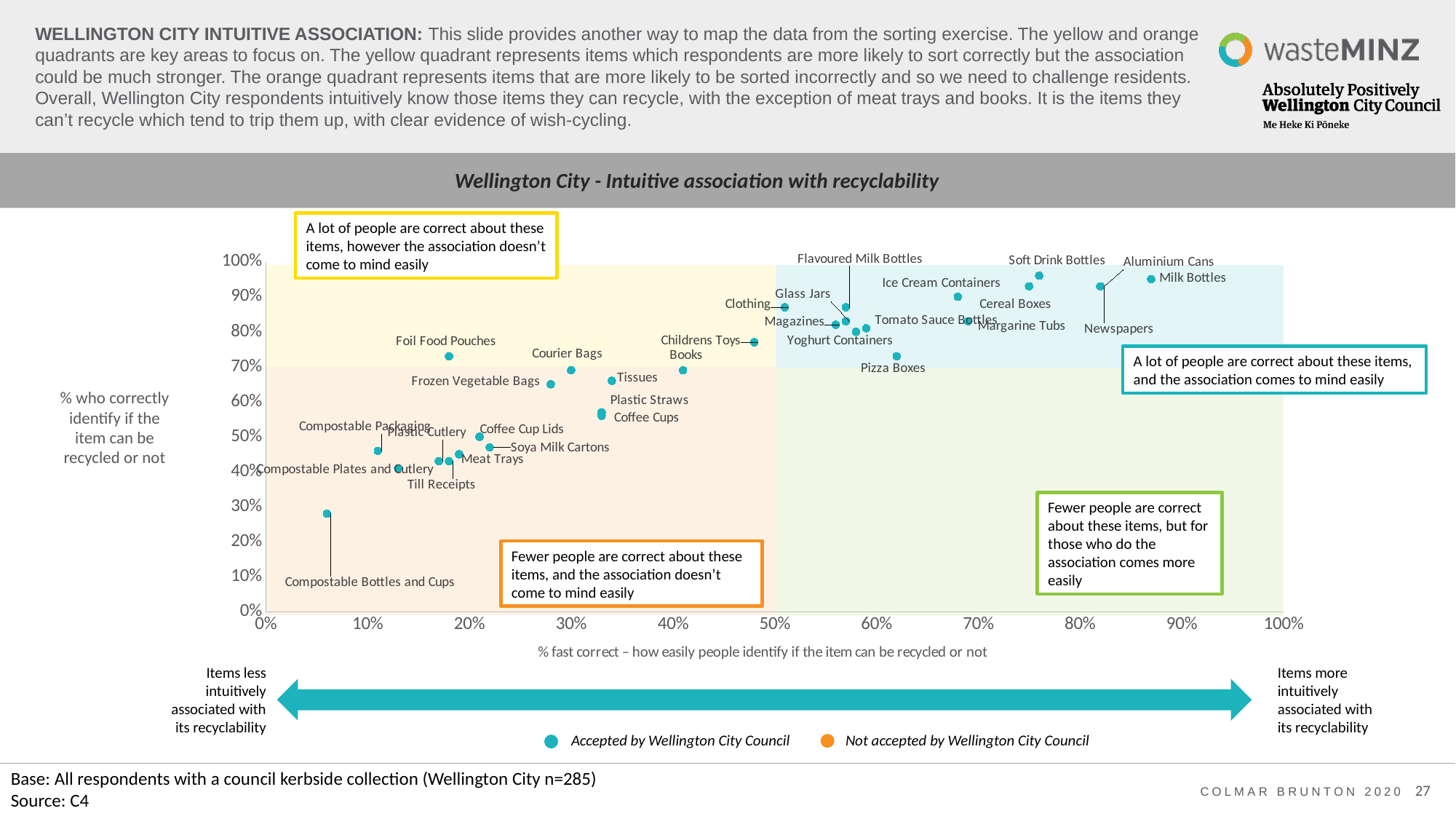
Is the vertical-axis value for Meat Trays greater or less than 50%? less What kind of chart is shown on the slide? Scatter chart Is the horizontal-axis value for Milk Bottles greater or less than 80%? greater What is the title of the chart? Wellington City - Intuitive association with recyclability Is the vertical-axis value for Tissues greater or less than 70%? less Which item has the lowest value on the vertical axis (% who correctly identify if the item can be recycled or not)? Compostable Bottles and Cups Which item has a higher horizontal-axis value, Pizza Boxes or Frozen Vegetable Bags? Pizza Boxes Which item has a higher vertical-axis value, Foil Food Pouches or Tissues? Foil Food Pouches Which item has the highest value on the horizontal axis (% fast correct)? Milk Bottles How many series does the chart legend list? 2